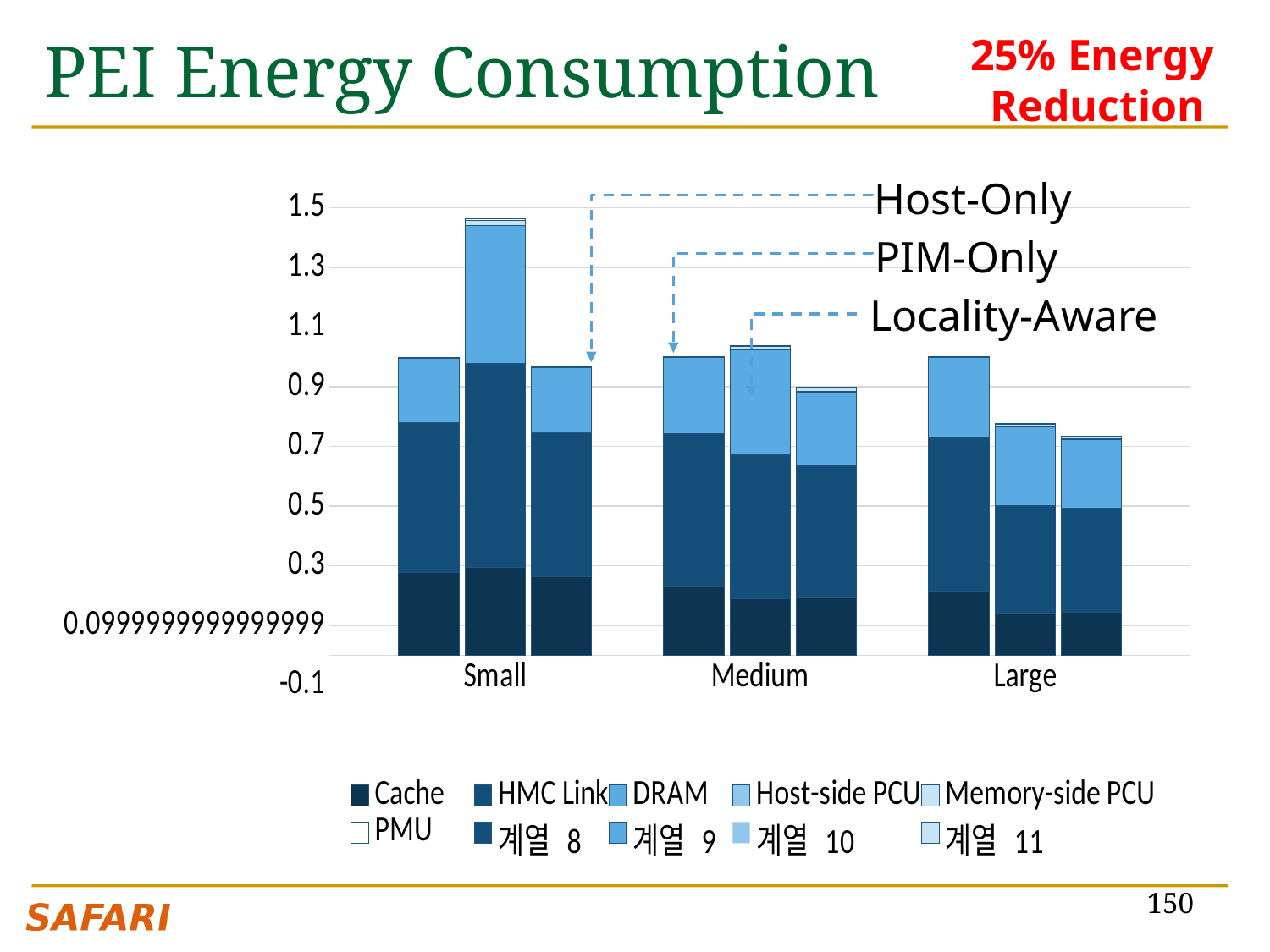
Is the Locality-Aware bar for Large greater or less than 0.9? less Which category group contains the tallest bar in the chart? Small What is the title of the chart on the slide? PEI Energy Consumption Do the PIM-Only bars rise or fall going from Small to Medium to Large? fall In the Large group, which bar is taller: Host-Only or Locality-Aware? Host-Only Is the PIM-Only bar for Medium greater or less than 0.9? greater In the Small group, which bar is taller: Host-Only or PIM-Only? PIM-Only Is the PIM-Only bar for Small greater or less than 1.3? greater What is the first entry listed in the chart's legend? Cache How many categories are shown on the x axis of the chart? 3 How many series does the chart's legend list? 10 What kind of chart is shown on the slide? stacked bar chart